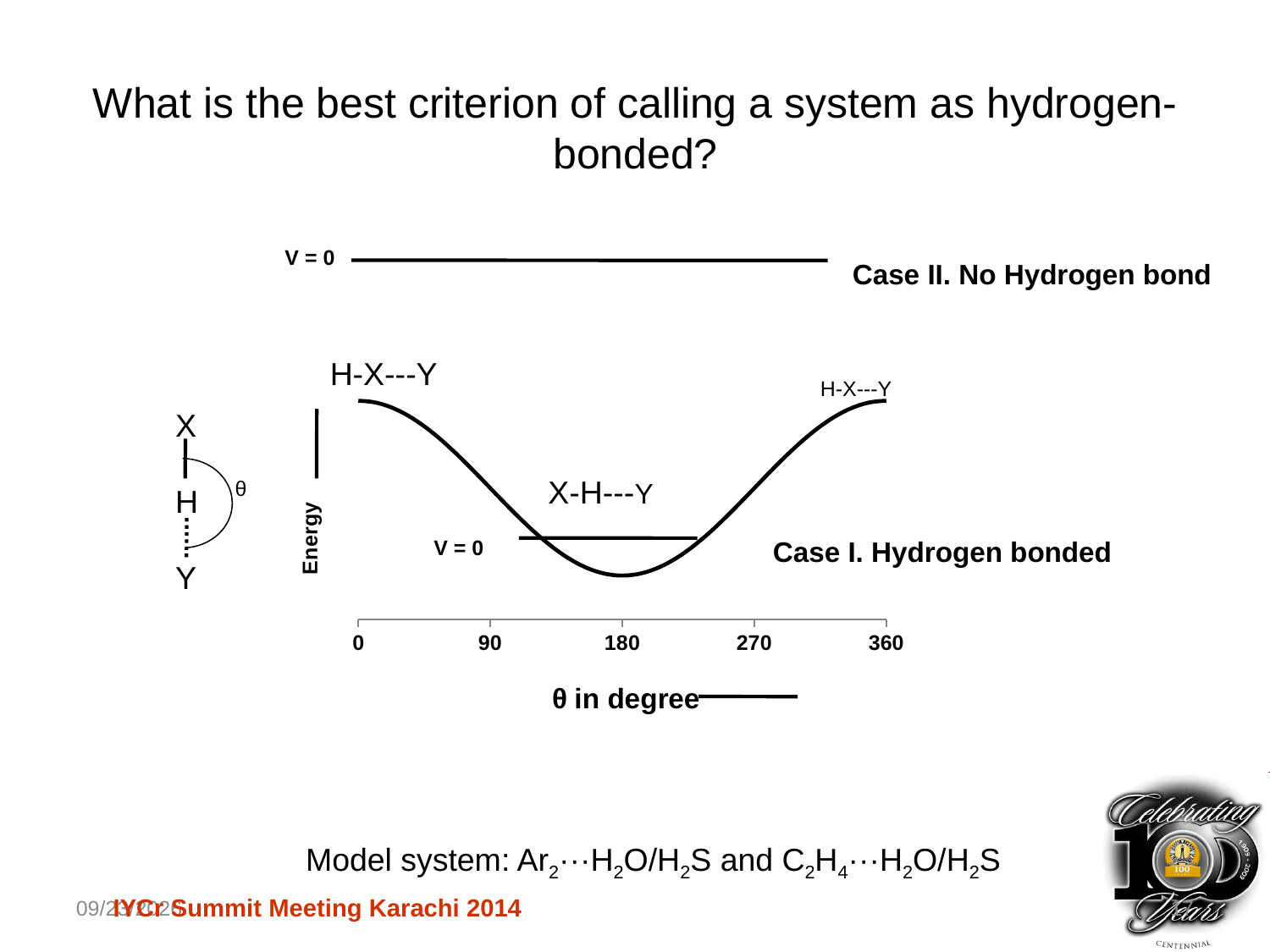
What kind of chart is shown on the slide? line chart Is the energy at θ = 180 greater or less than the V = 0 level marked on the curve? less What is the label of the y axis of the chart? Energy Does the energy curve rise or fall as θ goes from 0 to 180? fall Which is larger, the energy at θ = 90 or the energy at θ = 180? θ = 90 At which value of θ does the energy curve reach its lowest point? 180 What is the label of the x axis of the chart? θ in degree Is the energy at θ = 0 greater or less than the V = 0 level marked on the curve? greater Does the energy curve rise or fall as θ goes from 180 to 360? rise What is the largest tick value printed on the x axis? 360 How many tick values are printed on the x axis of the chart? 5